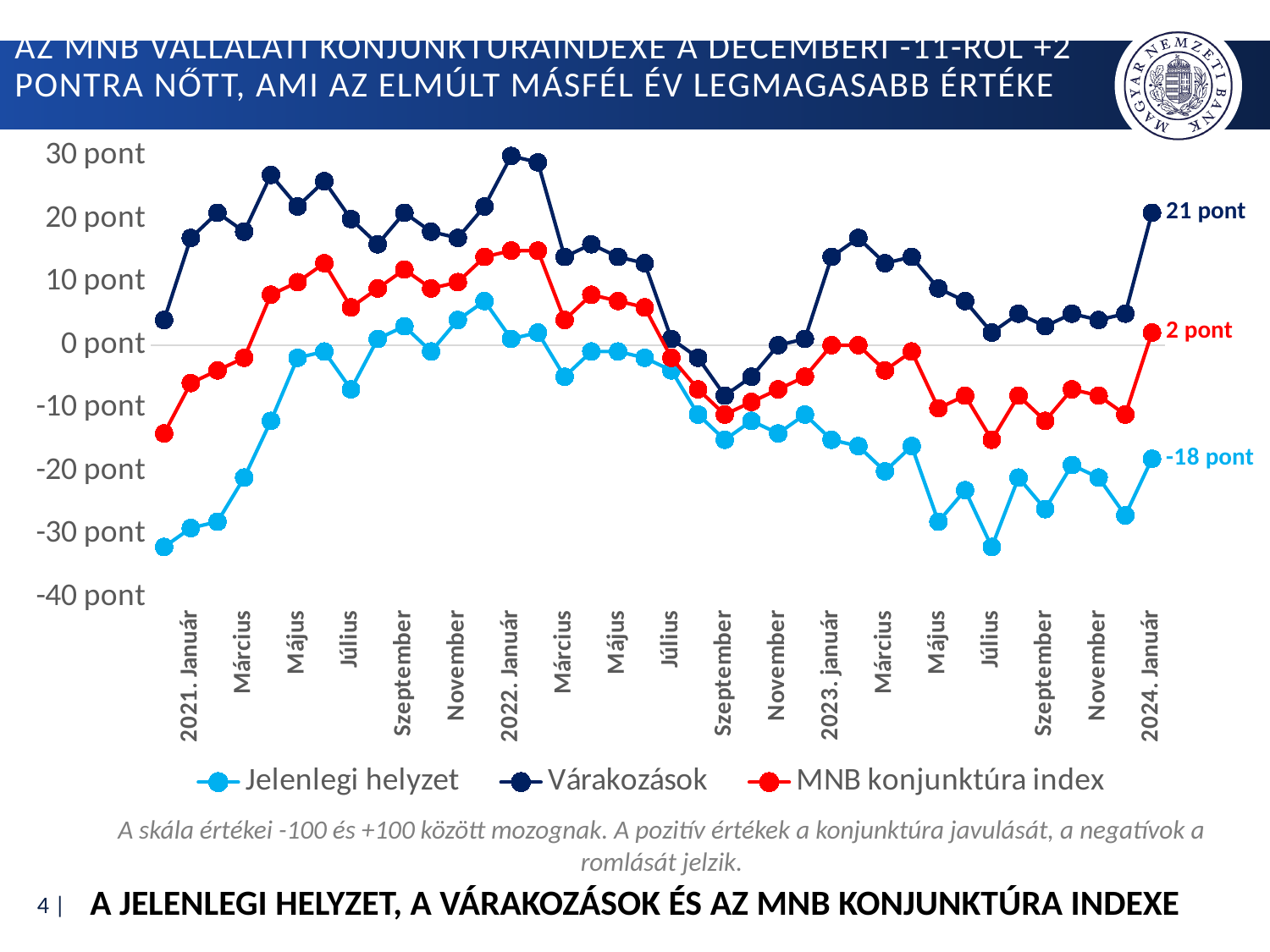
What kind of chart is shown on the slide? line chart How many series does the legend list? 3 Which series has the highest value in 2024. Január? Várakozások What is the value of the Várakozások series in 2024. Január? 21 pont What is the difference between the Várakozások value and the MNB konjunktúra index value in 2024. Január? 19 pont What is the value of the MNB konjunktúra index in 2024. Január? 2 pont Which series has the lowest value in 2024. Január? Jelenlegi helyzet What is the difference between the Várakozások value and the Jelenlegi helyzet value in 2024. Január? 39 pont What is the value of the Jelenlegi helyzet series in 2024. Január? -18 pont Is the value of Várakozások in 2022. Január greater or less than 20 pont? greater Which colour is used for the MNB konjunktúra index series? red